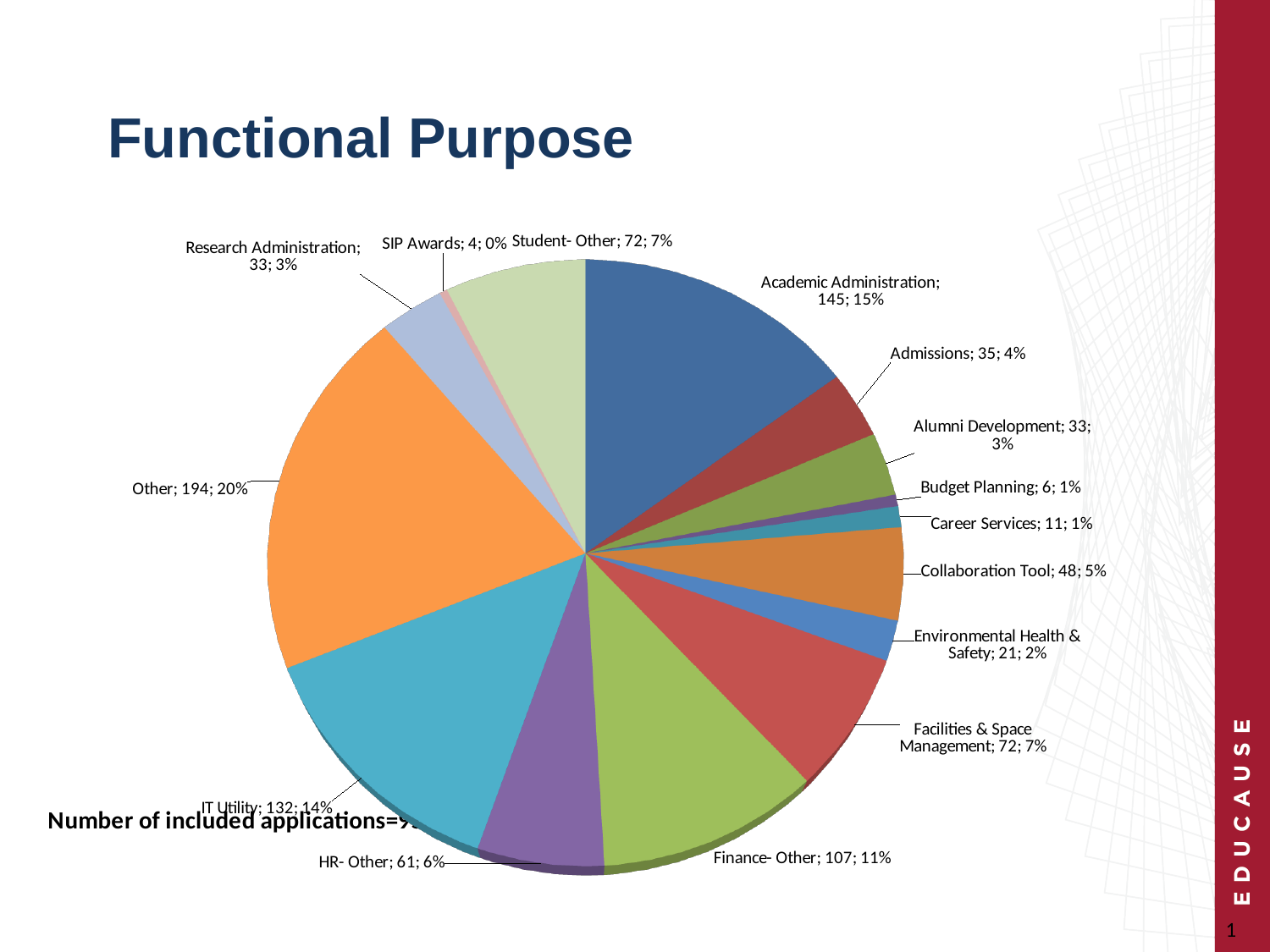
What is the value for IT Utility? 132 What is the difference between the values for Other and Academic Administration? 49 What percentage share does the Other slice have? 20% Which category has the smallest slice of the pie? SIP Awards What percentage share does Collaboration Tool have? 5% What is the title of the slide containing the pie chart? Functional Purpose How many categories does the pie chart show? 15 How many applications are in the Academic Administration slice? 145 What is the value for Budget Planning? 6 Which is larger, the value for Finance- Other or the value for Facilities & Space Management? Finance- Other What kind of chart is shown on the slide? pie chart Which category has the largest slice of the pie? Other